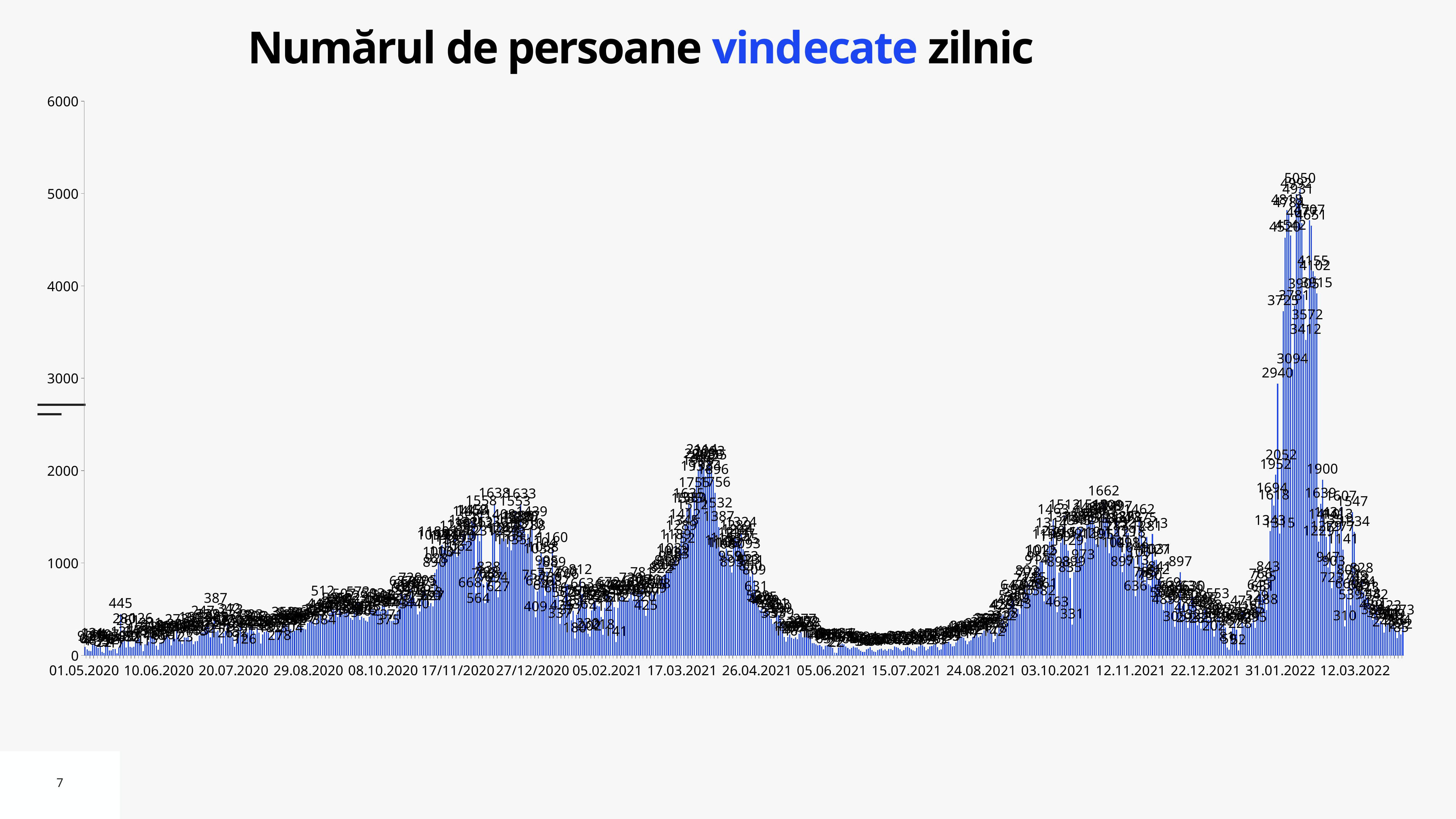
Is the peak around 17.03.2021 greater or less than 2000? greater How many data series are plotted on the chart? 1 Are the values around 15.07.2021 greater or less than 500? less What kind of chart is shown on the slide? bar chart Which peak is higher: the one around 17.03.2021 or the one around 12.11.2021? 17.03.2021 Do the values rise or fall between 26.04.2021 and 05.06.2021? fall What is the highest value labelled on the chart? 5050 What is the highest labelled value in the peak around 12.11.2021? 1662 What is the title of the chart? Numărul de persoane vindecate zilnic What is the first date shown on the x axis? 01.05.2020 Is the tallest bar on the chart greater or less than 5000? greater Do the values rise or fall between 24.08.2021 and 03.10.2021? rise